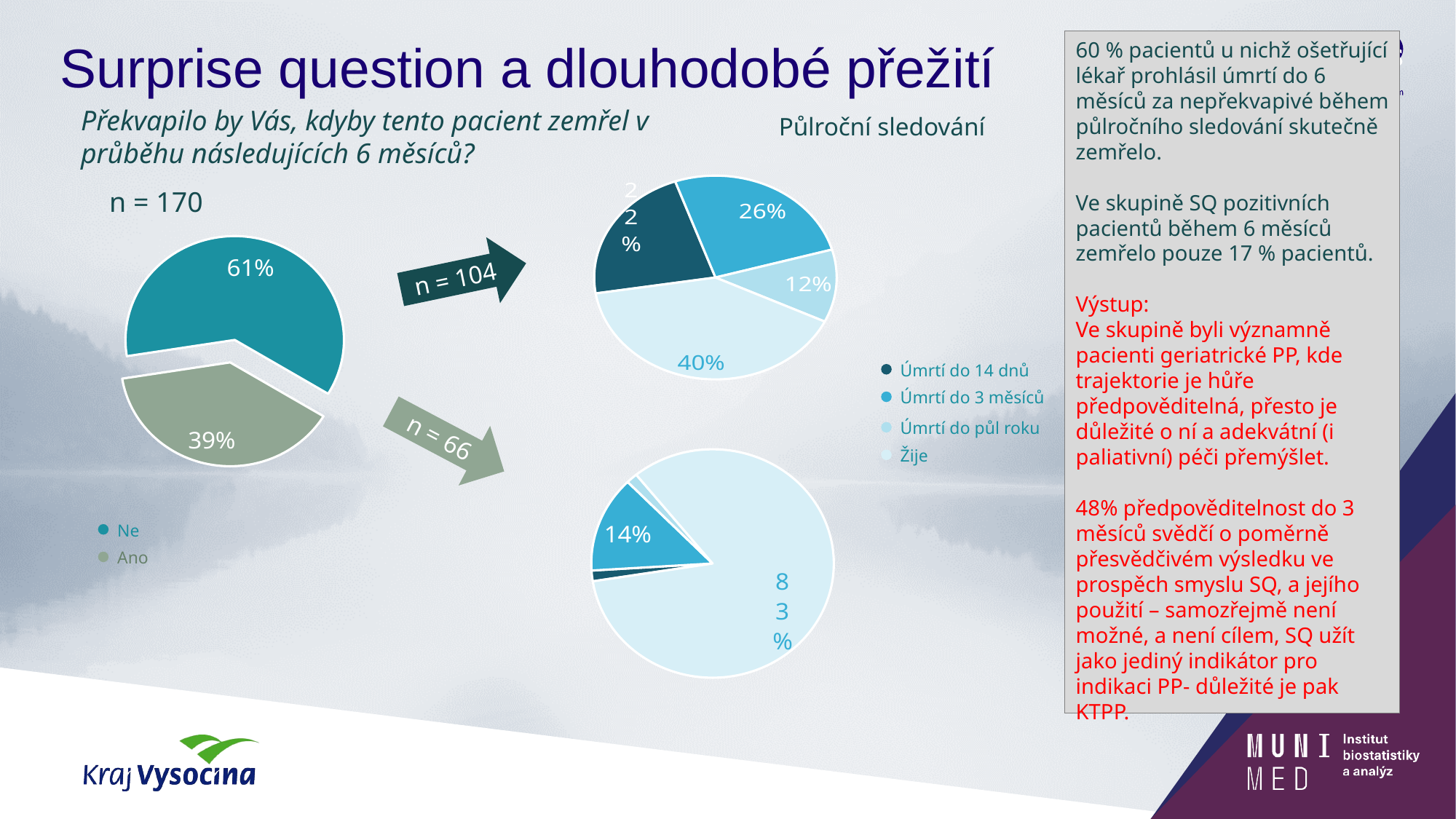
In the top-right pie chart (n = 104), what percentage is shown for 'Žije'? 40% How many categories does the legend for the right-hand pie charts list? 4 In the left pie chart (n = 170), what percentage is shown for the 'Ano' slice? 39% In the left pie chart (n = 170), what is the difference in percentage points between the 'Ne' and 'Ano' slices? 22 In the left pie chart (n = 170), which slice is larger, 'Ne' or 'Ano'? Ne In the top-right pie chart (n = 104), what percentage is shown for 'Úmrtí do 3 měsíců'? 26% In the left pie chart (n = 170), what percentage is shown for the 'Ne' slice? 61% What kind of chart is used for the n = 170 data on the left? Pie chart In the top-right pie chart (n = 104), what percentage is shown for 'Úmrtí do půl roku'? 12% In the top-right pie chart (n = 104), which category has the smallest share? Úmrtí do půl roku In the top-right pie chart (n = 104), which category has the largest share? Žije In the bottom-right pie chart (n = 66), what percentage is shown for 'Žije'? 83%